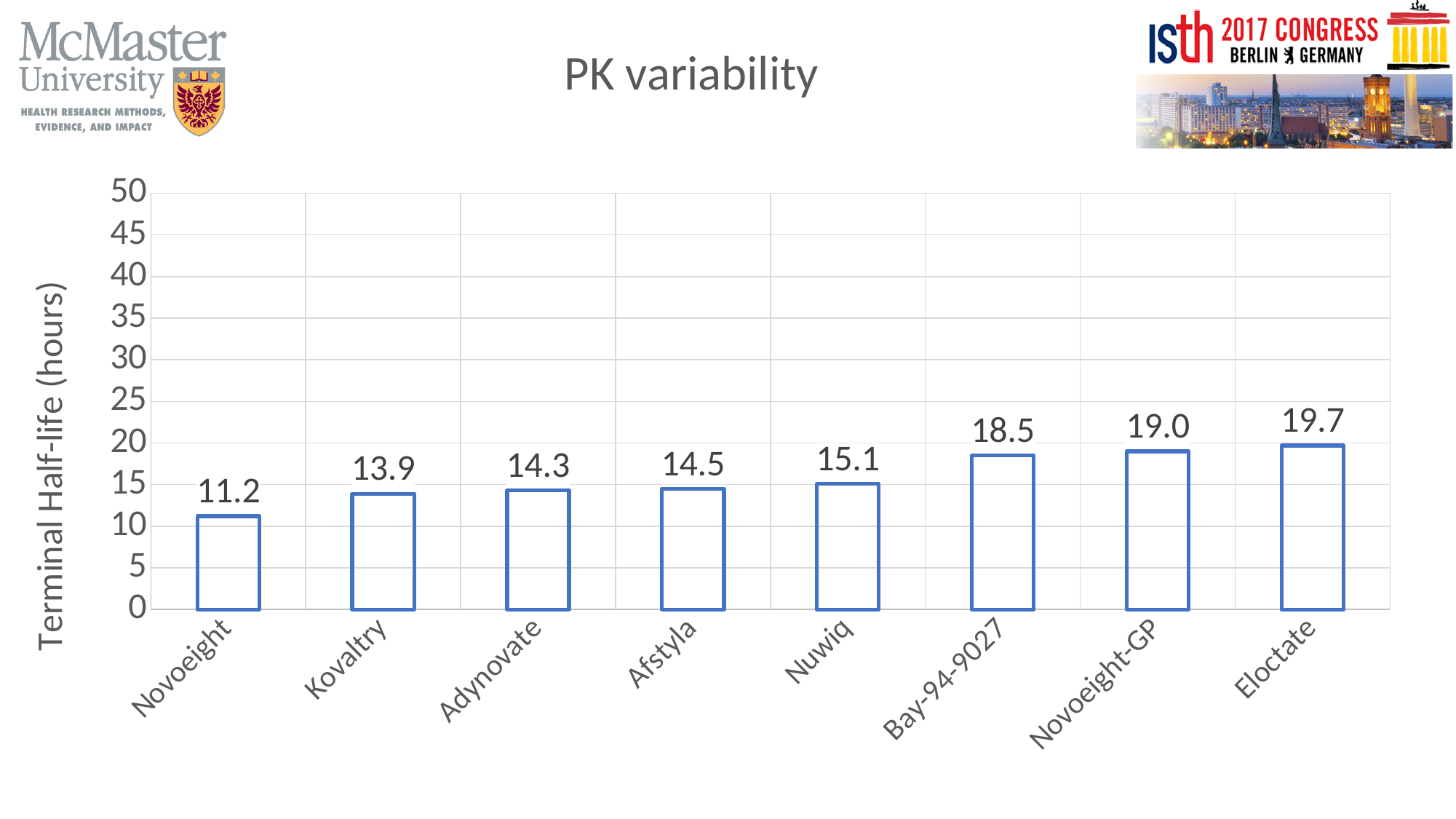
How many products are shown on the chart? 8 Is the value for Bay-94-9027 greater or less than 20? less What is the terminal half-life for Bay-94-9027? 18.5 Which product has the highest terminal half-life? Eloctate What is the difference in terminal half-life between Eloctate and Novoeight? 8.5 What is the terminal half-life for Afstyla? 14.5 What kind of chart is shown on the slide? bar chart What is the terminal half-life for Novoeight? 11.2 What is the label of the y axis? Terminal Half-life (hours) Which has a longer terminal half-life, Nuwiq or Adynovate? Nuwiq Which product has the lowest terminal half-life? Novoeight What is the difference in terminal half-life between Novoeight-GP and Kovaltry? 5.1